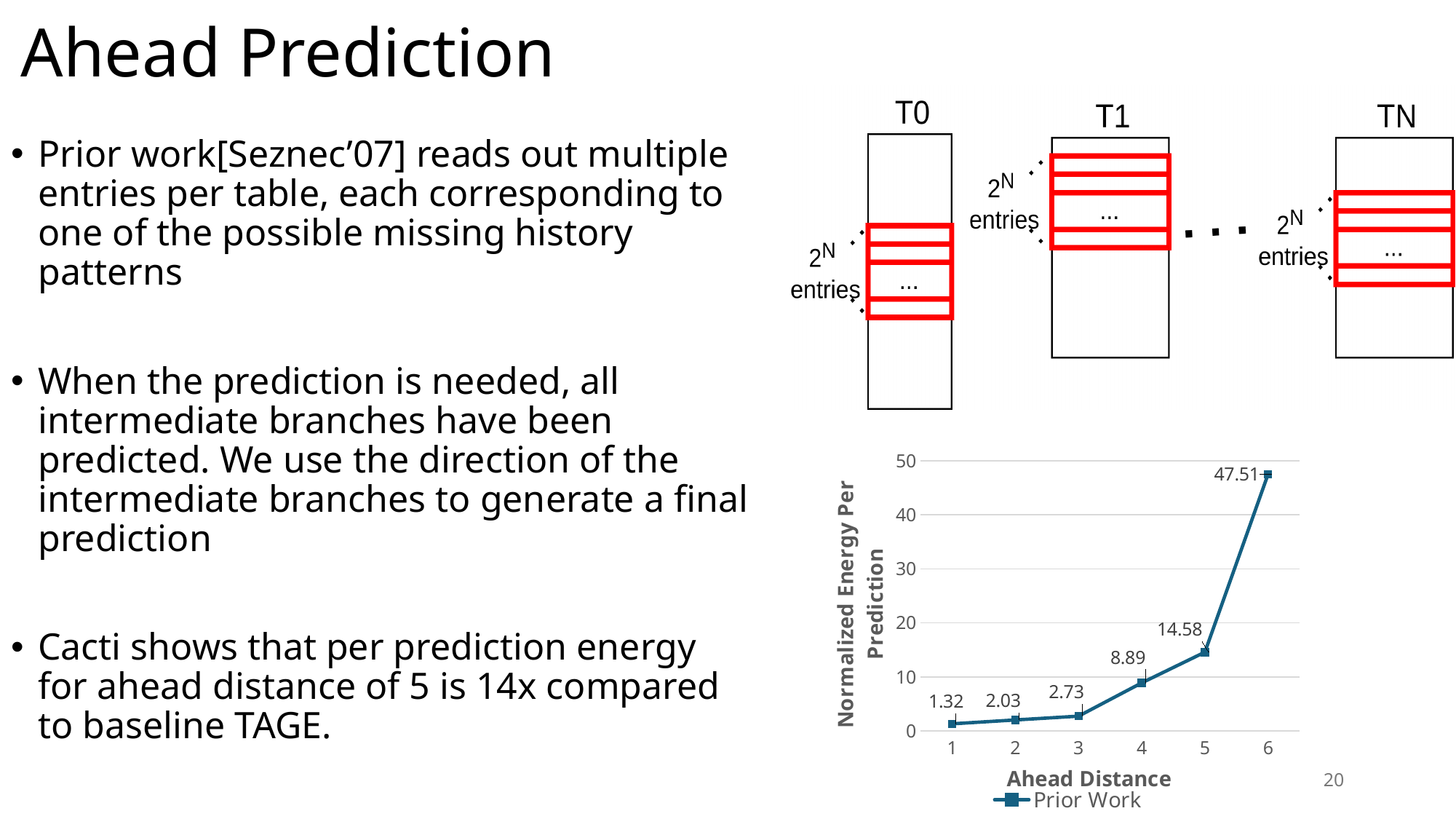
Which has a higher normalized energy per prediction: ahead distance 3 or ahead distance 4? Ahead distance 4 At which ahead distance is the normalized energy per prediction highest? 6 How many ahead distance points are plotted on the chart? 6 What is the normalized energy per prediction at ahead distance 1? 1.32 Is the normalized energy per prediction at ahead distance 6 greater or less than 40? greater Does the normalized energy per prediction rise or fall as ahead distance increases? Rises What is the normalized energy per prediction at ahead distance 5? 14.58 At which ahead distance is the normalized energy per prediction lowest? 1 How many series does the chart legend list? 1 What is the normalized energy per prediction at ahead distance 4? 8.89 What kind of chart is used to show normalized energy per prediction versus ahead distance? Line chart What is the difference in normalized energy per prediction between ahead distance 6 and ahead distance 5? 32.93